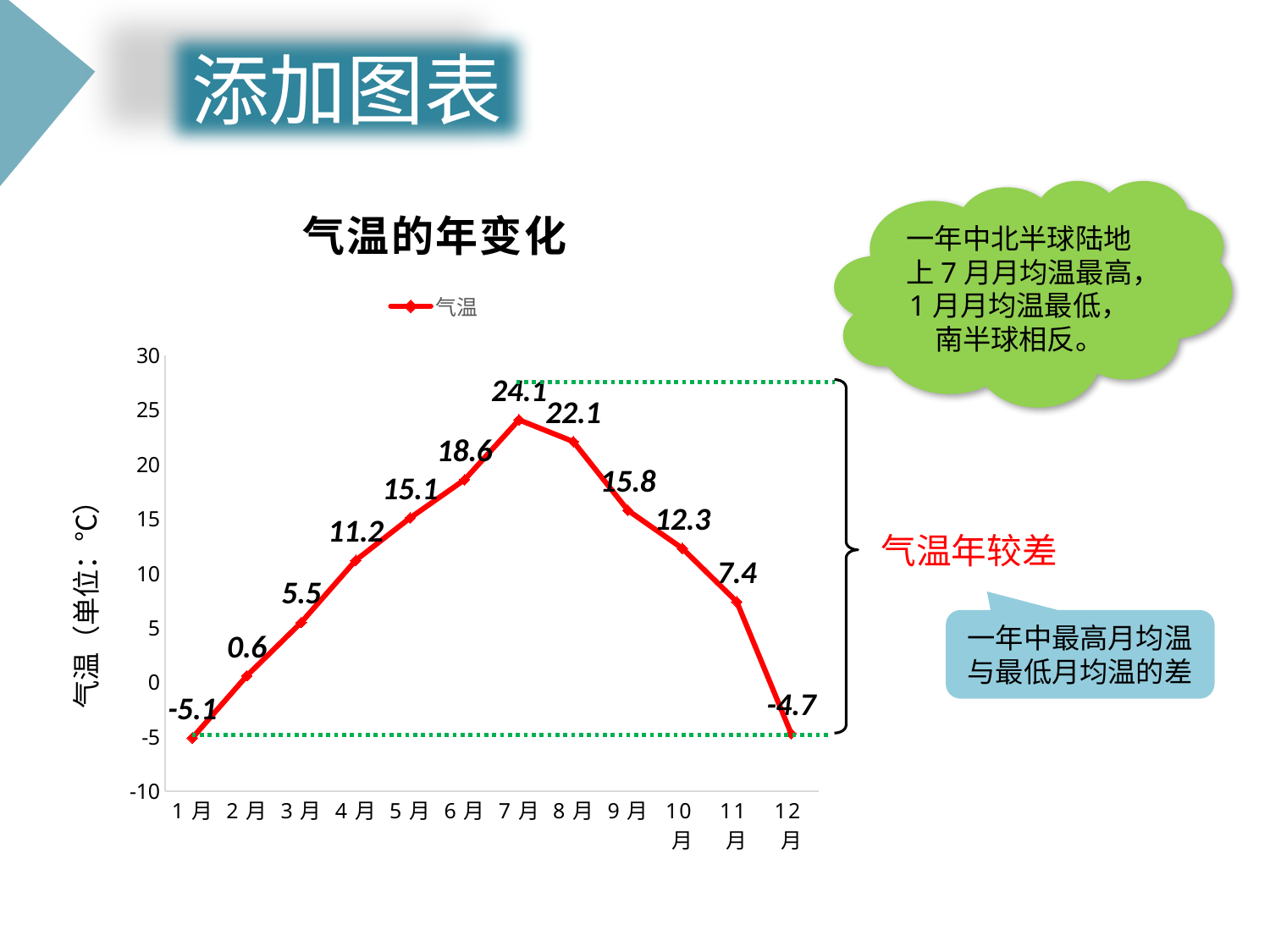
Is the temperature for 8月 greater or less than 20 in the chart 气温的年变化? greater How many series does the legend of the chart 气温的年变化 list? 1 Which month has the lowest temperature in the chart 气温的年变化? 1月 Does the temperature rise or fall from 1月 to 7月 in the chart 气温的年变化? rise How many months are plotted in the chart 气温的年变化? 12 What is the temperature value for 1月 in the chart 气温的年变化? -5.1 What is the difference between the temperature for 7月 and the temperature for 1月 in the chart 气温的年变化? 29.2 What kind of chart is 气温的年变化? line chart What is the temperature value for 10月 in the chart 气温的年变化? 12.3 What is the temperature value for 7月 in the chart 气温的年变化? 24.1 Which month has the highest temperature in the chart 气温的年变化? 7月 Which is larger in the chart 气温的年变化: the temperature for 6月 or the temperature for 9月? 6月